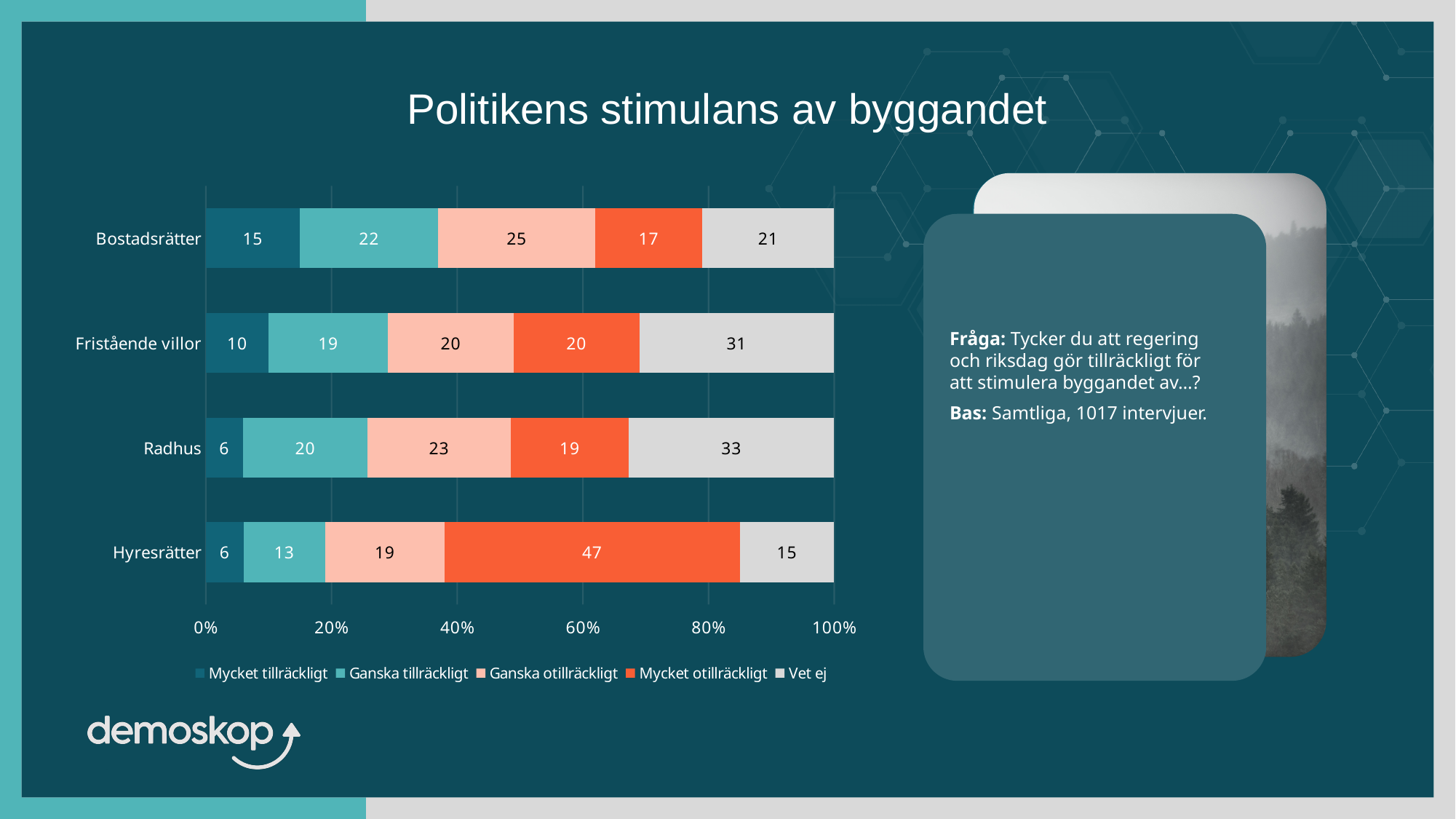
Which category has the lowest value for Vet ej? Hyresrätter How many categories are shown on the chart? 4 How many series does the legend list? 5 What is the difference between the Vet ej values for Radhus and Bostadsrätter? 12 What is the value for Mycket tillräckligt for Bostadsrätter? 15 What is the title of the chart? Politikens stimulans av byggandet Which category has the highest value for Mycket otillräckligt? Hyresrätter What is the value for Vet ej for Radhus? 33 What is the total of the stacked bar for Radhus? 101 What kind of chart is shown on the slide? Stacked bar chart What is the value for Mycket otillräckligt for Hyresrätter? 47 Which has the larger Ganska tillräckligt value, Bostadsrätter or Fristående villor? Bostadsrätter